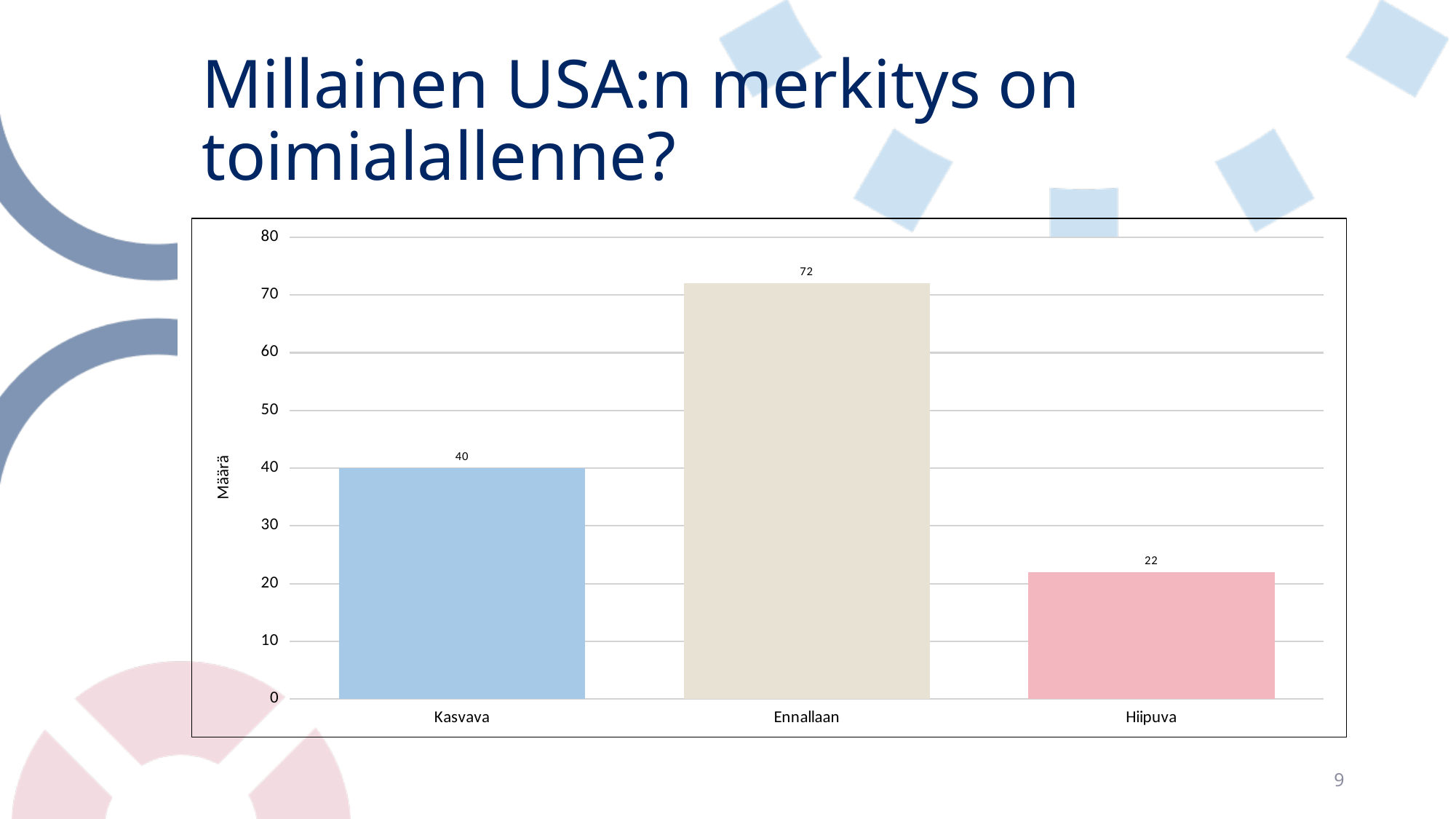
How many categories are shown on the x axis? 3 Which is larger, the value for Kasvava or the value for Hiipuva? Kasvava Which category has the lowest value? Hiipuva What is the value for Hiipuva? 22 What is the difference between the values for Ennallaan and Kasvava? 32 Is the value for Ennallaan greater or less than 60? greater What is the label of the vertical axis? Määrä What kind of chart is shown on the slide? bar chart What is the difference between the values for Kasvava and Hiipuva? 18 What is the value for Ennallaan? 72 What is the value for Kasvava? 40 Which category has the highest value? Ennallaan